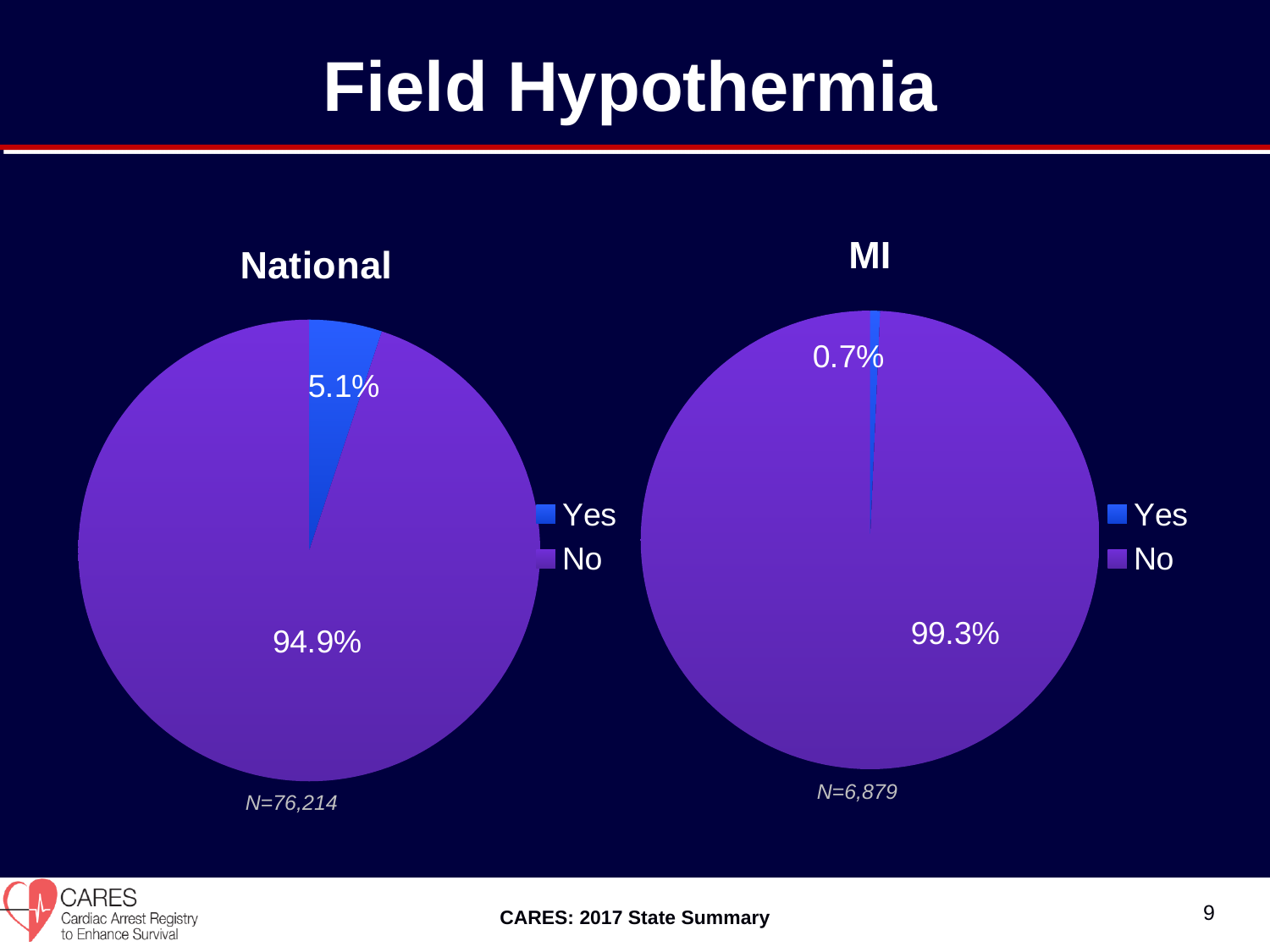
What type of chart is the National chart? Pie chart In the MI chart, what percentage is shown for Yes? 0.7% In the National chart, which category has the largest slice? No How many categories does the legend of the MI chart list? 2 In the MI chart, what percentage is shown for No? 99.3% What is the N value shown below the MI chart? N=6,879 Which is larger: the Yes share in the National chart or the Yes share in the MI chart? National In the National chart, what percentage is shown for No? 94.9% What is the difference between the No share in the MI chart and the No share in the National chart? 4.4% In the National chart, what percentage is shown for Yes? 5.1% In the MI chart, which category has the smallest slice? Yes What is the N value shown below the National chart? N=76,214